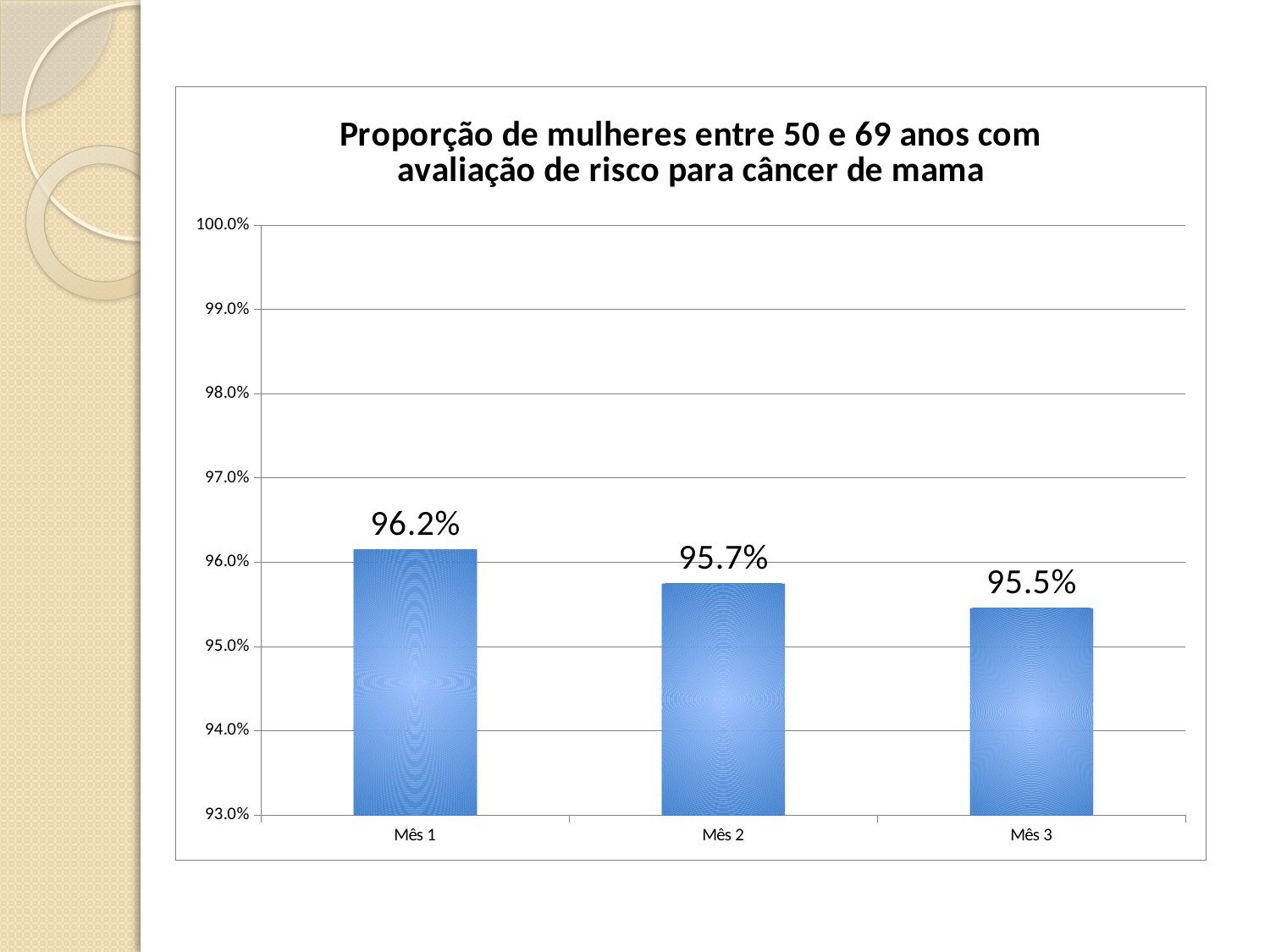
What is the value for Mês 2? 95.7% Which month has the lowest value? Mês 3 How many months are shown on the chart? 3 What is the difference between the values for Mês 1 and Mês 2? 0.5% Which is larger, the value for Mês 2 or the value for Mês 3? Mês 2 Which month has the highest value? Mês 1 Do the values rise or fall from Mês 1 to Mês 3? fall What is the difference between the values for Mês 1 and Mês 3? 0.7% Is the value for Mês 1 greater or less than 96.0%? greater What is the value for Mês 1? 96.2% What is the value for Mês 3? 95.5% What kind of chart is shown on the slide? bar chart